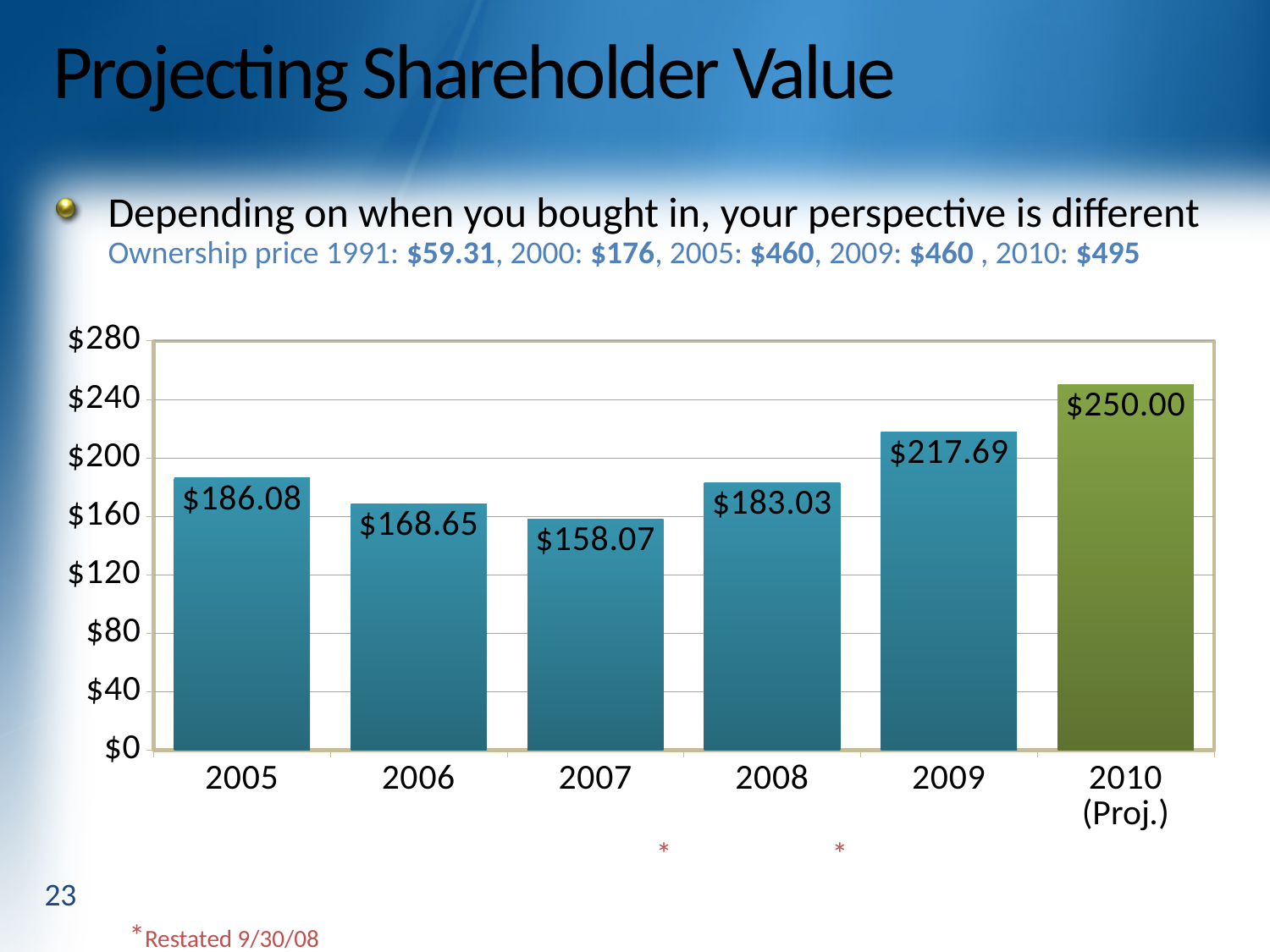
Is the value for 2009 greater or less than $200? greater Which year has the lowest value in the chart? 2007 What is the difference between the 2009 value and the 2008 value? $34.66 Which is larger, the value for 2005 or the value for 2008? 2005 What is the value shown for 2007? $158.07 Do the values rise or fall from 2007 to 2010 (Proj.)? rise What is the value shown for 2005? $186.08 Which bar is shown in a different colour (green) from the others? 2010 (Proj.) What kind of chart is shown on the slide? bar chart How many years are plotted in the chart? 6 What is the value shown for 2010 (Proj.)? $250.00 Which year has the highest value in the chart? 2010 (Proj.)